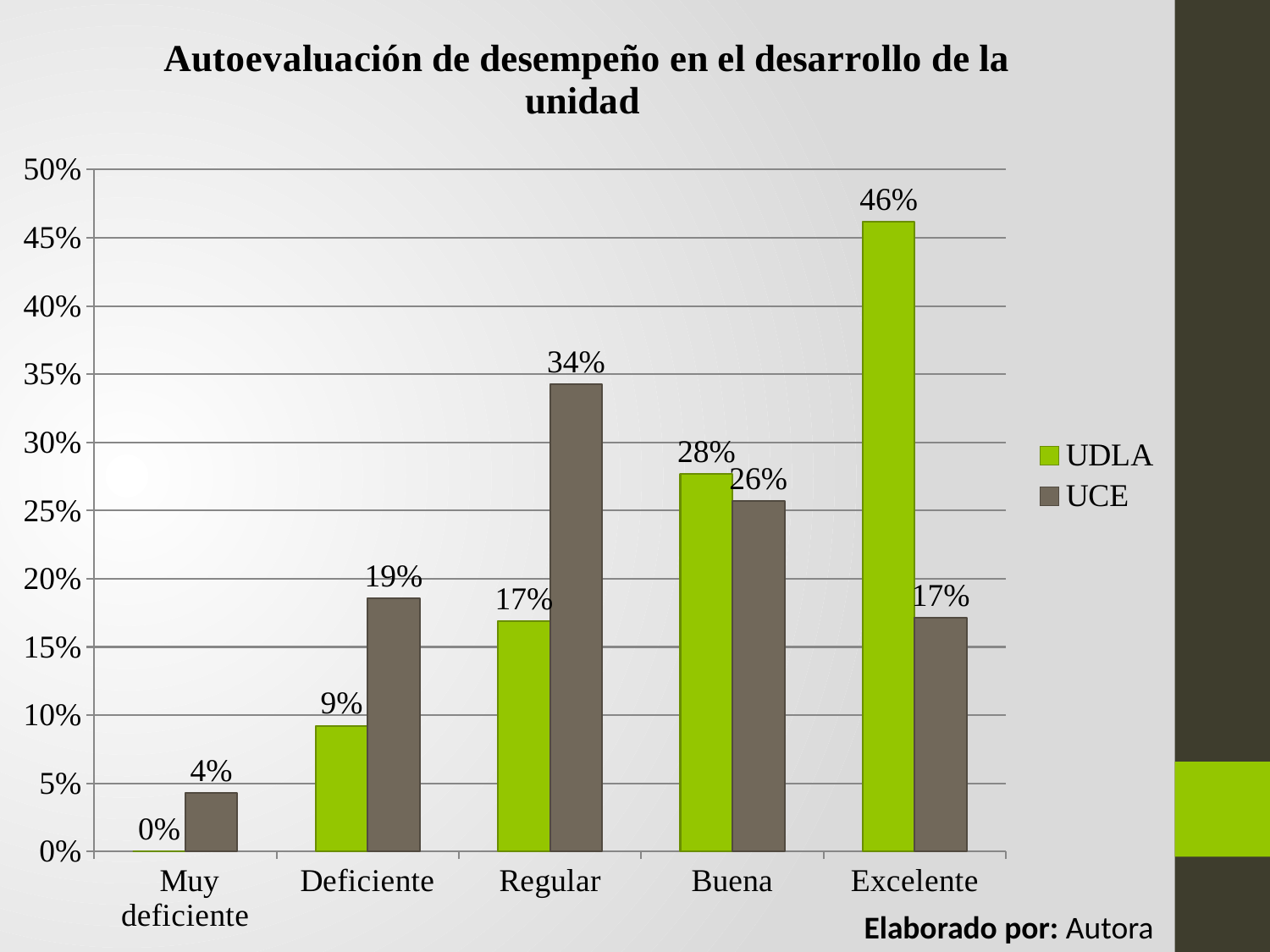
What kind of chart is shown on the slide? Bar chart How many categories are shown on the x axis? 5 How many series does the legend list? 2 What is the UCE value for Deficiente? 19% Which category has the lowest UCE value? Muy deficiente What is the UDLA value for Muy deficiente? 0% What is the difference between the UDLA and UCE values for Excelente? 29% Which is larger for Regular, the UDLA value or the UCE value? UCE What colour represents the UDLA series? Green What is the UDLA value for Excelente? 46% Which category has the highest UDLA value? Excelente What is the UCE value for Regular? 34%